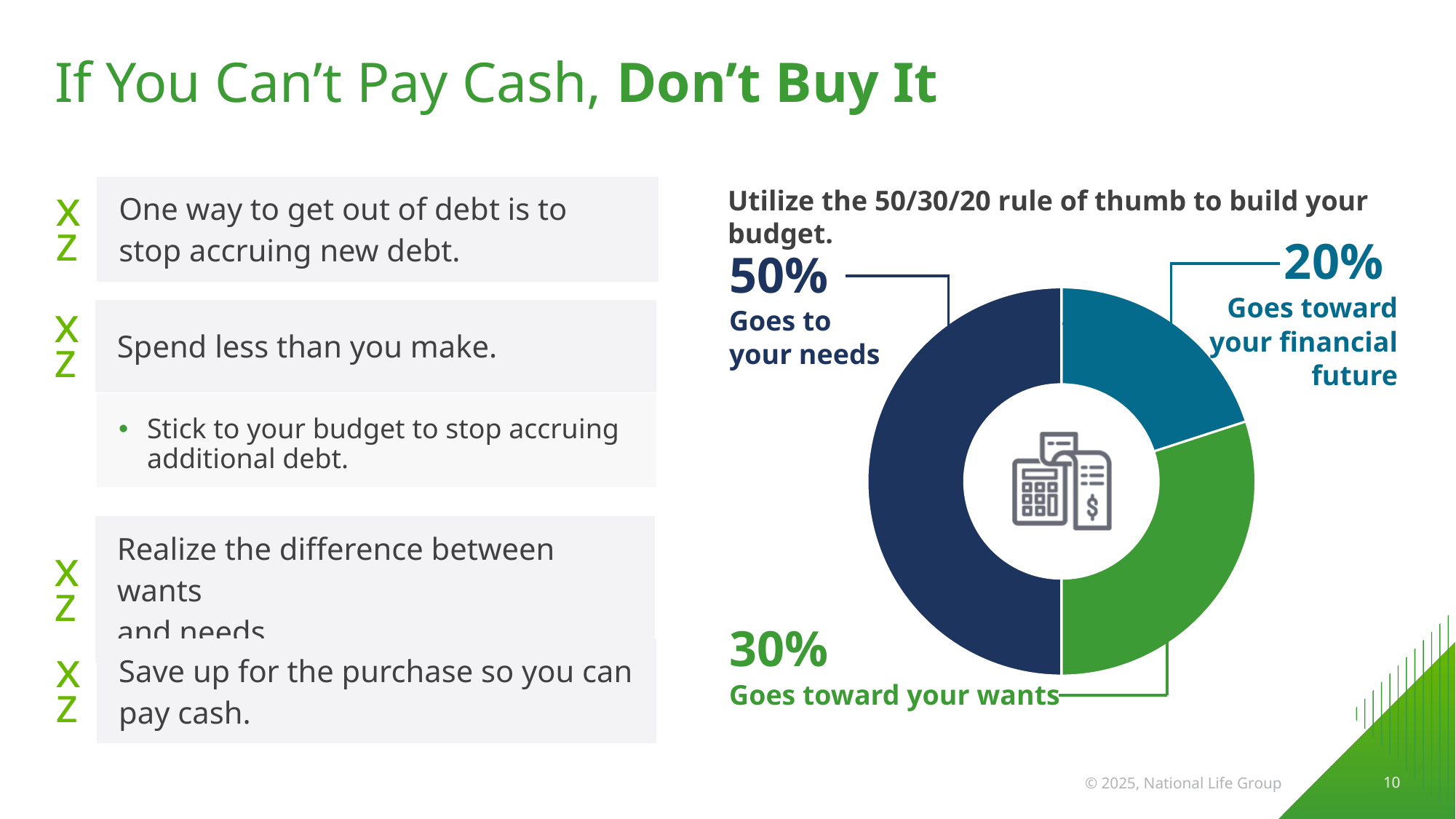
What colour is the segment for wants? Green Which is larger, the share for wants or the share for financial future? Wants What rule of thumb does the chart illustrate? The 50/30/20 rule of thumb Which category has the smallest share of the chart? Goes toward your financial future What is the difference between the share for wants and the share for financial future? 10% What is the difference between the share for needs and the share for wants? 20% What percentage goes toward your financial future? 20% What percentage goes toward your wants? 30% How many segments does the chart have? 3 What percentage goes to your needs? 50% Which category has the largest share of the chart? Goes to your needs What kind of chart is shown on the slide? Doughnut chart